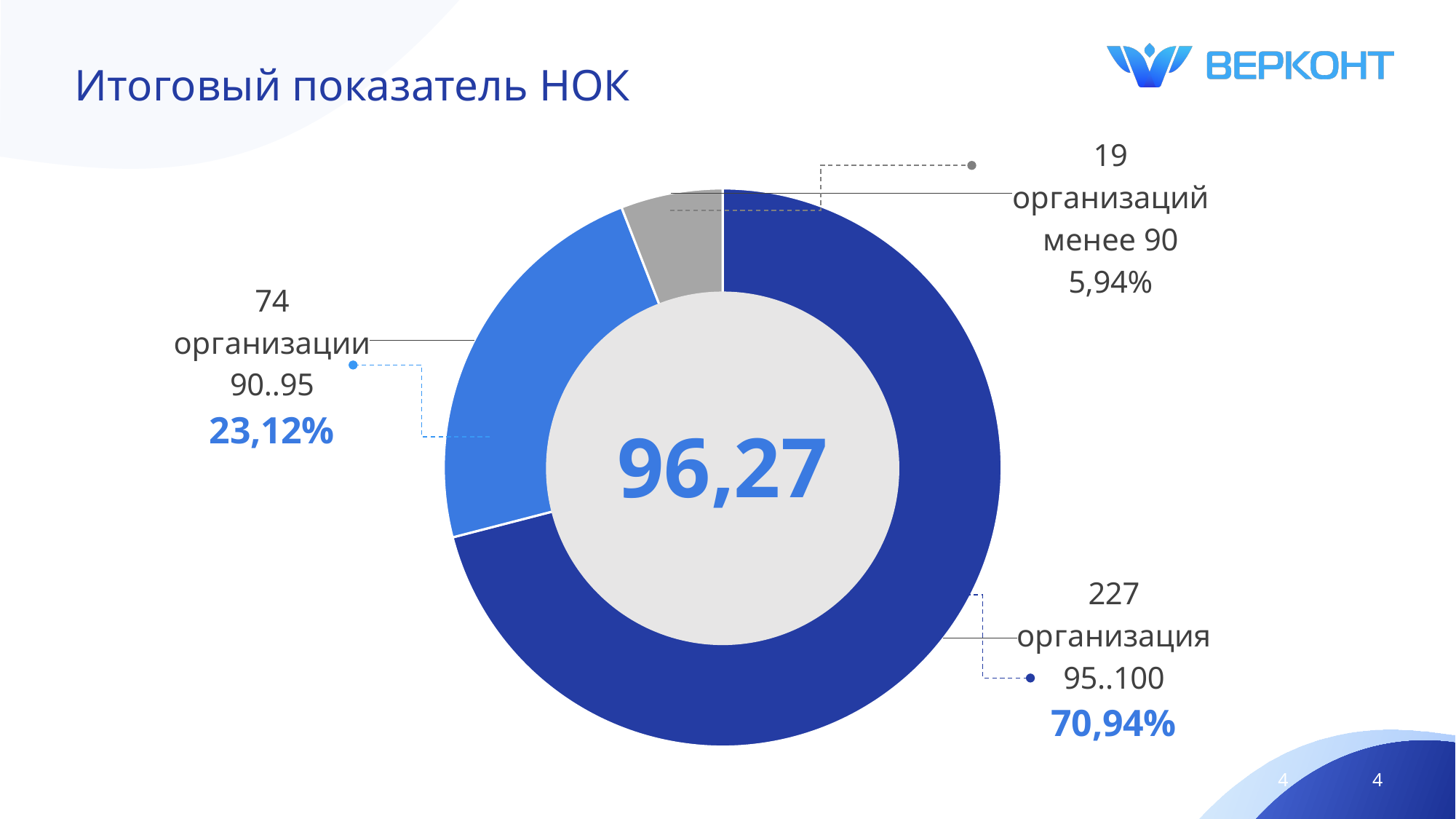
Which segment of the donut chart is the largest? 95..100 (227 организация) What is the title of the slide's chart? Итоговый показатель НОК How many segments does the donut chart have? 3 How many organisations have a score of 90..95? 74 What share of the chart is taken by organisations with a score of less than 90 (менее 90)? 5,94% What type of chart is shown on the slide? Pie (donut) chart What value is printed in the centre of the donut chart? 96,27 Which segment of the donut chart is the smallest? менее 90 (19 организаций) What share of the chart is taken by organisations with a score of 95..100? 70,94% How many organisations have a score of 95..100? 227 What share of the chart is taken by organisations with a score of 90..95? 23,12% How many organisations have a score of less than 90 (менее 90)? 19